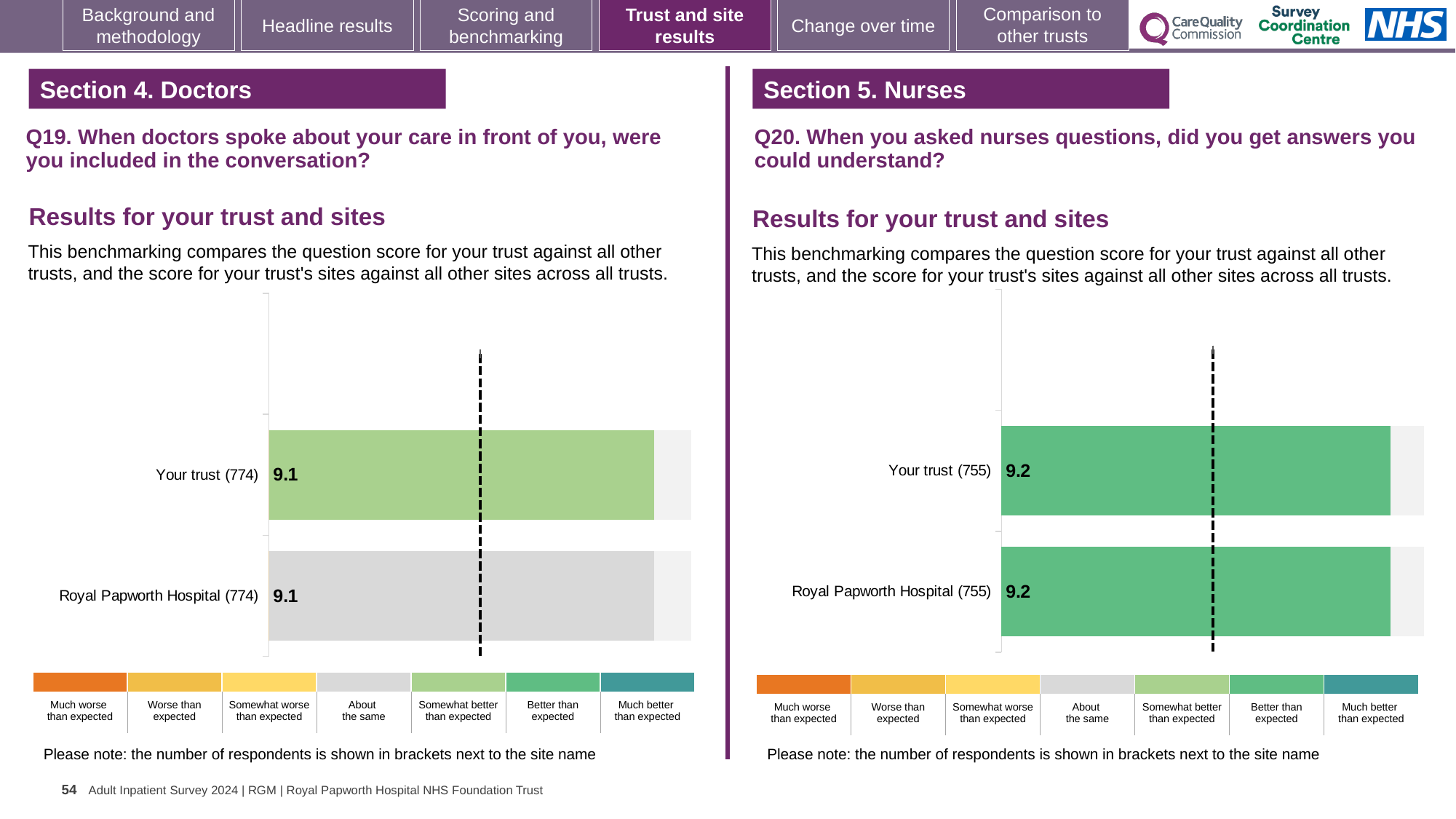
How many bars are plotted on the Q20 chart (right)? 2 On the Q20 chart (right), how many respondents are shown in brackets next to Royal Papworth Hospital? 755 On the Q19 chart (left), what is the score for Your trust? 9.1 What type of chart is used on the Q19 chart (left)? Bar chart On the Q19 chart (left), how many respondents are shown in brackets next to Your trust? 774 On the Q19 chart (left), which benchmark category does the colour of the Royal Papworth Hospital bar correspond to? About the same On the Q20 chart (right), which benchmark category does the colour of the Your trust bar correspond to? Better than expected On the Q20 chart (right), what is the score for Royal Papworth Hospital? 9.2 On the Q20 chart (right), what is the score for Your trust? 9.2 Is the score for Your trust on the Q20 chart (right) larger or smaller than the score for Your trust on the Q19 chart (left)? Larger On the Q19 chart (left), what is the score for Royal Papworth Hospital? 9.1 On the Q19 chart (left), what is the difference between the score for Your trust and the score for Royal Papworth Hospital? 0